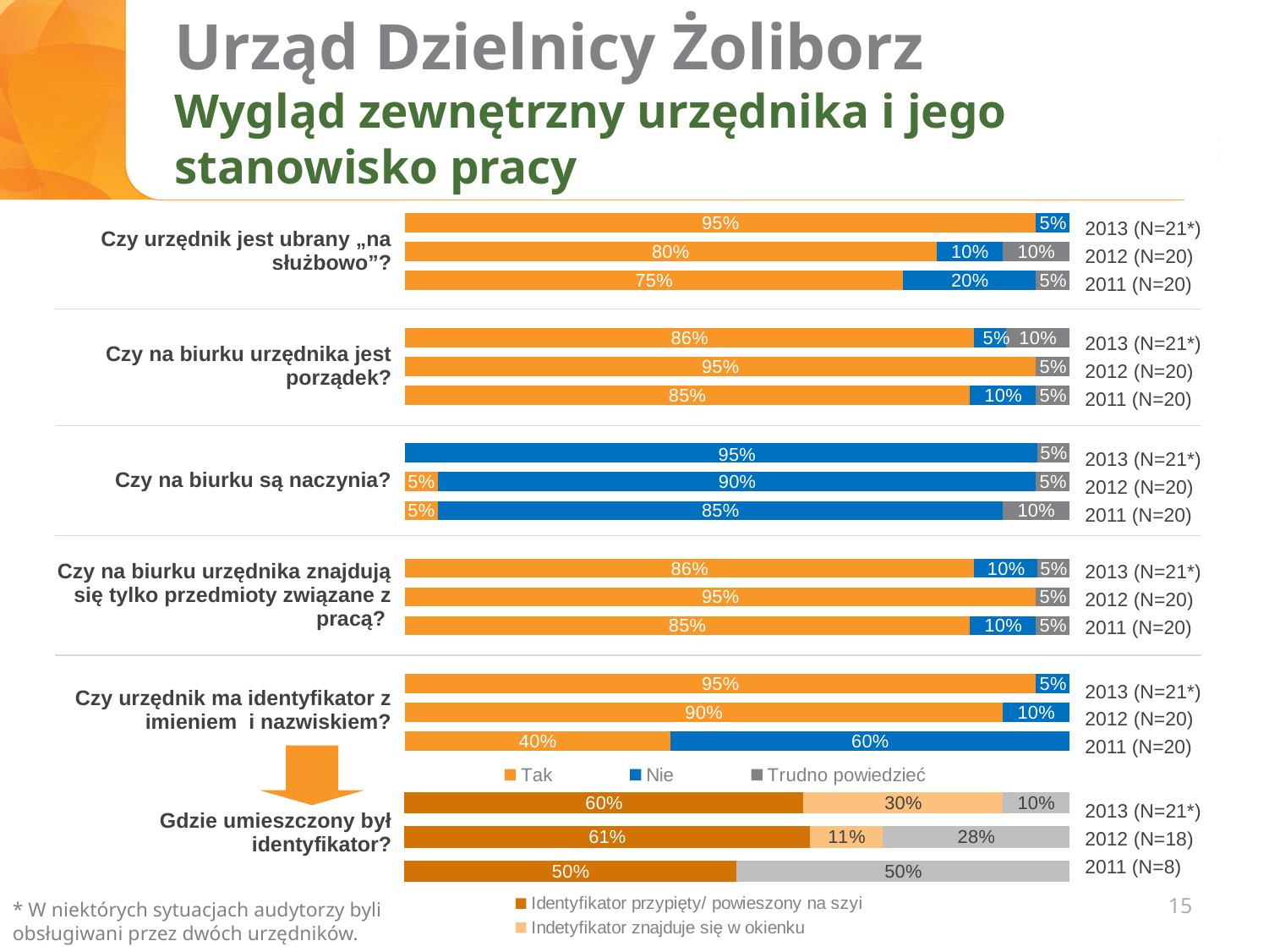
In the chart 'Gdzie umieszczony był identyfikator?', what is the value for 'Identyfikator przypięty/ powieszony na szyi' in 2012 (N=18)? 61% In the upper chart, what is the 'Trudno powiedzieć' value for 'Czy na biurku urzędnika jest porządek?' in 2013 (N=21*)? 10% In the upper chart, what is the 'Nie' value for 'Czy urzędnik ma identyfikator z imieniem i nazwiskiem?' in 2011 (N=20)? 60% In the upper chart, does the 'Tak' value for 'Czy urzędnik ma identyfikator z imieniem i nazwiskiem?' rise or fall from 2011 to 2013? Rises In the upper chart, what is the difference in percentage points between the 'Tak' value for 'Czy urzędnik jest ubrany „na służbowo”?' in 2013 and in 2011? 20 percentage points In the upper chart, what is the 'Nie' value for 'Czy urzędnik jest ubrany „na służbowo”?' in 2011 (N=20)? 20% How many series does the legend of the upper chart list? 3 In the chart 'Gdzie umieszczony był identyfikator?', what is the value for 'Indetyfikator znajduje się w okienku' in 2013 (N=21*)? 30% In the upper chart, what is the 'Nie' value for 'Czy na biurku są naczynia?' in 2013 (N=21*)? 95% In the upper chart (Tak/Nie/Trudno powiedzieć), what is the 'Tak' value for 'Czy urzędnik jest ubrany „na służbowo”?' in 2013 (N=21*)? 95% What kind of chart is used on this slide? Stacked bar chart In the upper chart, which year has the larger 'Tak' value for 'Czy urzędnik ma identyfikator z imieniem i nazwiskiem?': 2013 or 2011? 2013